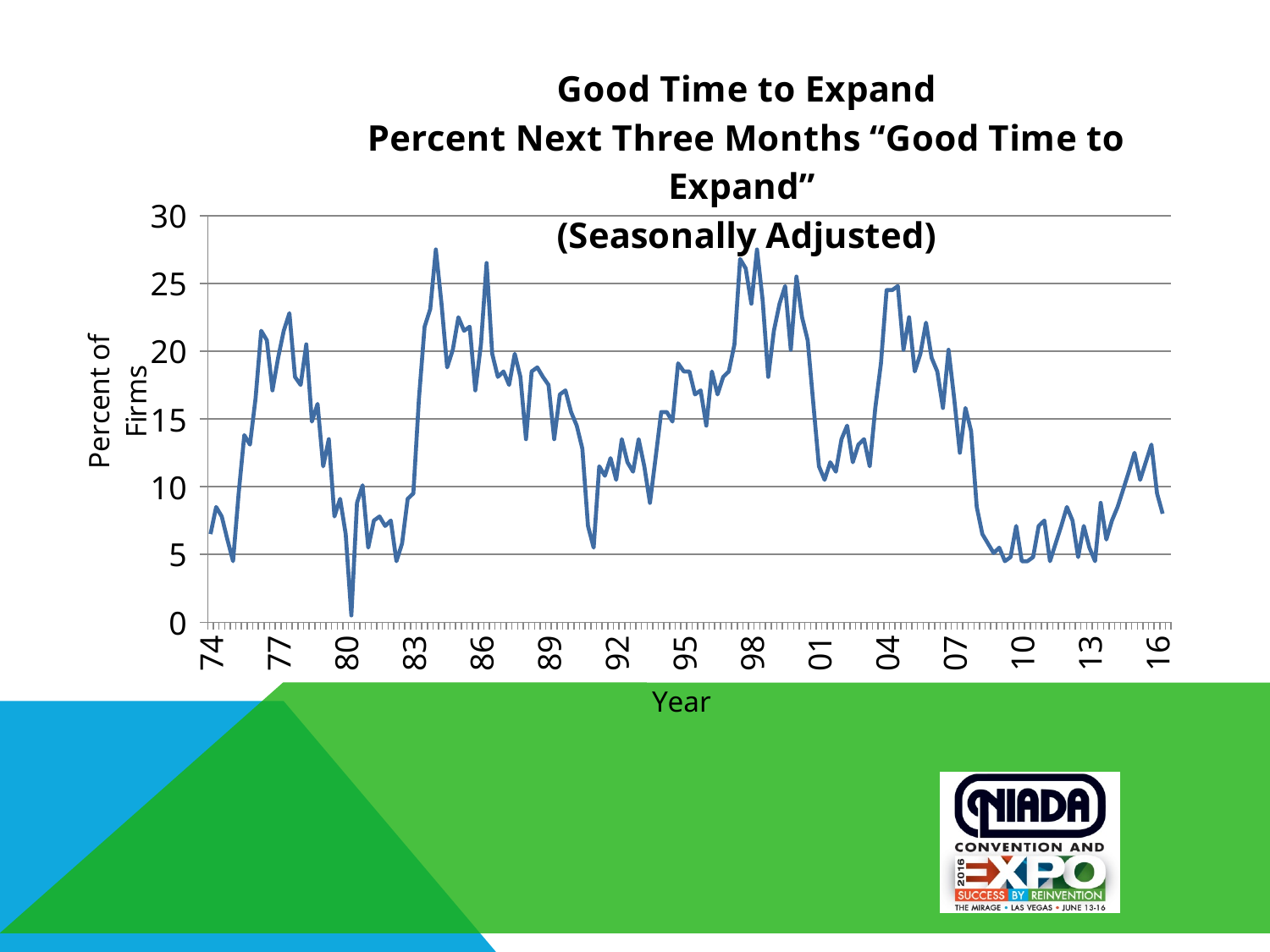
Is the value at the peak around 1998 greater or less than 25? greater Is the value for the lowest point around 1980 greater or less than 5? less Is the value at the peak around 1984 greater or less than 25? greater Which is larger, the peak value around 1984 or the peak value around 2015? the peak around 1984 What is the label on the vertical axis of the chart? Percent of Firms What kind of chart is shown on the slide? line chart Between 2007 and 2010, does the line generally rise or fall? fall What is the main title of the chart? Good Time to Expand How many lines (data series) are plotted on the chart? 1 Between 1981 and 1984, does the line generally rise or fall? rise